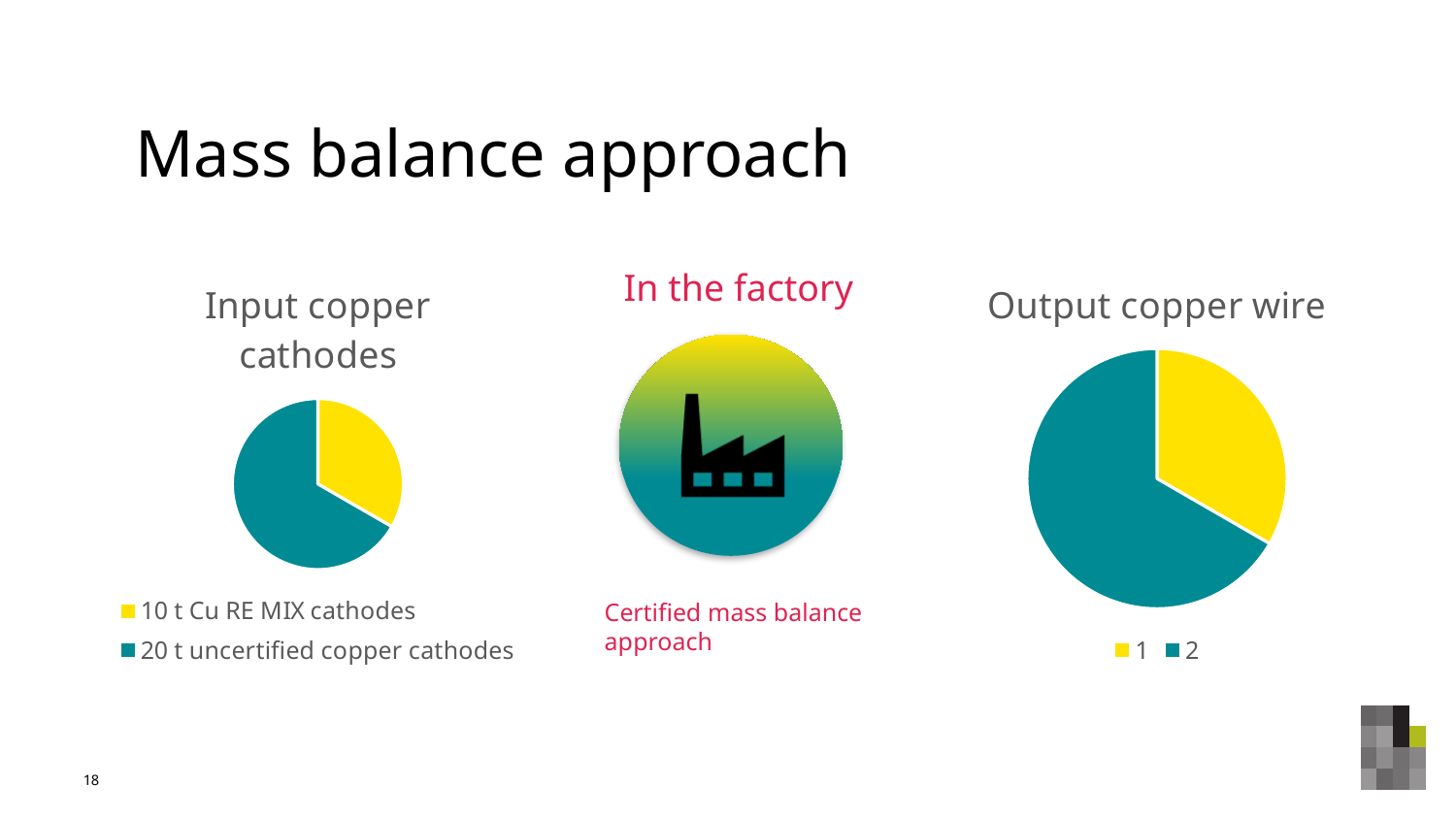
In the "Output copper wire" chart, how many slices does the pie have? 2 In the "Input copper cathodes" chart, which slice is the largest? 20 t uncertified copper cathodes What kind of chart is shown under the title "Output copper wire"? pie chart In the "Output copper wire" chart, which slice is the smallest? 1 What is the title of the pie chart on the right side of the slide? Output copper wire In the "Input copper cathodes" chart, what colour is the slice for "10 t Cu RE MIX cathodes"? yellow What kind of chart is shown under the title "Input copper cathodes"? pie chart In the "Input copper cathodes" chart, how many slices does the pie have? 2 In the "Output copper wire" chart, how many entries does the legend list? 2 In the "Input copper cathodes" chart, how many entries does the legend list? 2 In the "Input copper cathodes" chart, which slice is the smallest? 10 t Cu RE MIX cathodes In the "Output copper wire" chart, which slice is larger, 1 or 2? 2